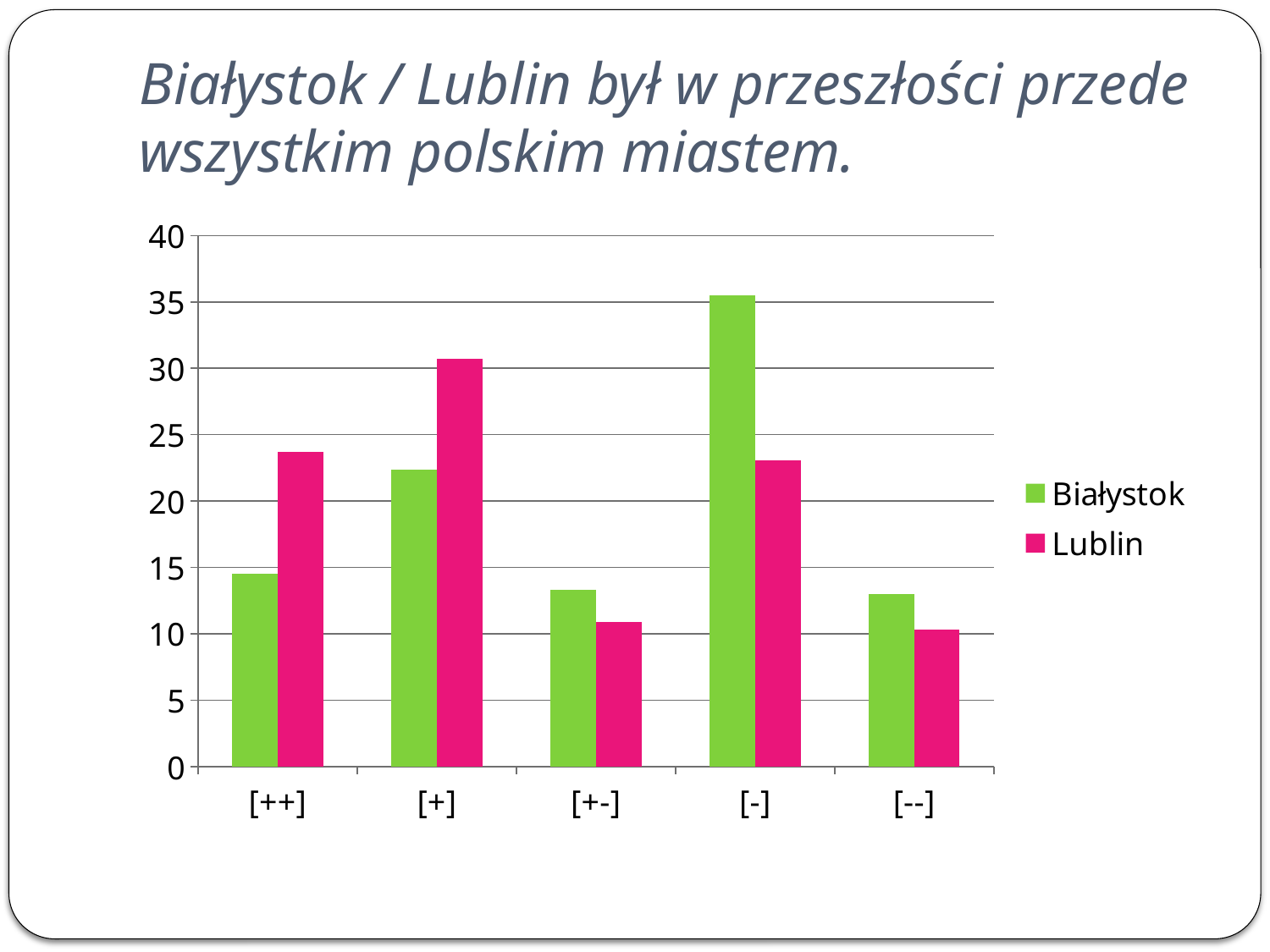
Is the value for Białystok in the [++] category greater or less than 20? less Is the value for Białystok in the [-] category greater or less than 30? greater Which colour represents Lublin in the legend? pink What kind of chart is shown on the slide? bar chart In the [++] category, which is larger: Białystok or Lublin? Lublin Which category has the highest value for Lublin? [+] In the [+] category, which is larger: Białystok or Lublin? Lublin Which category has the highest value for Białystok? [-] How many categories are shown on the x axis? 5 Is the value for Lublin in the [+-] category greater or less than 15? less In the [-] category, which is larger: Białystok or Lublin? Białystok How many series does the legend list? 2